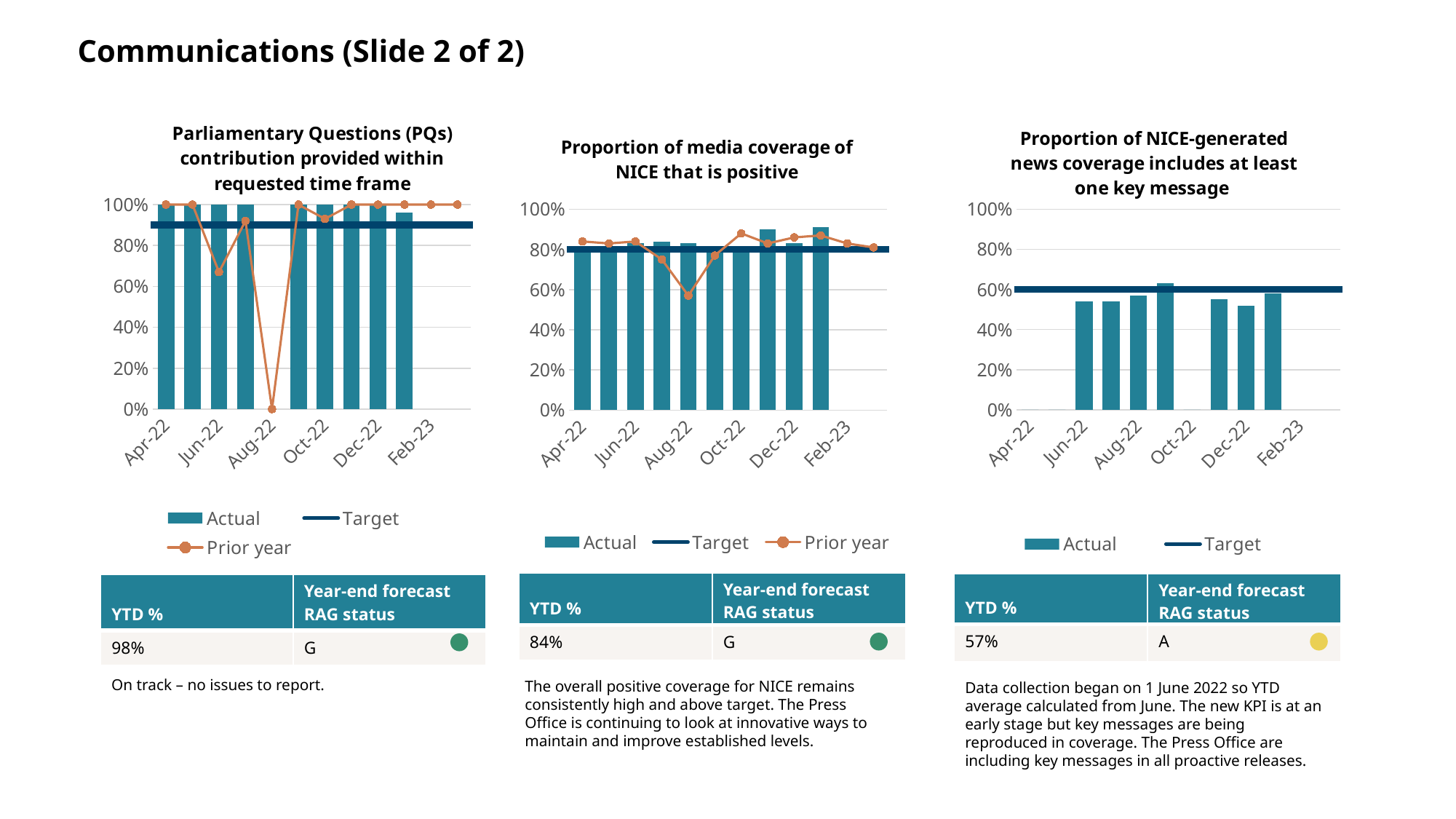
In the 'Proportion of NICE-generated news coverage includes at least one key message' chart, which month has the highest Actual bar? Sep-22 In the 'Proportion of NICE-generated news coverage includes at least one key message' chart, how many Actual bars are plotted? 7 What kind of chart is the 'Proportion of NICE-generated news coverage includes at least one key message' chart? bar chart In the 'Parliamentary Questions (PQs) contribution provided within requested time frame' chart, how many Actual bars are plotted? 9 What is the title of the middle chart on the slide? Proportion of media coverage of NICE that is positive In the 'Parliamentary Questions (PQs) contribution provided within requested time frame' chart, which month has the lowest Prior year value? Aug-22 In the 'Proportion of media coverage of NICE that is positive' chart, is the Actual value for Nov-22 greater or less than 80%? greater In the 'Proportion of NICE-generated news coverage includes at least one key message' chart, is the Actual value for Jun-22 greater or less than 60%? less In the 'Proportion of NICE-generated news coverage includes at least one key message' chart, how many series does the legend list? 2 In the 'Parliamentary Questions (PQs) contribution provided within requested time frame' chart, what is the Prior year value for Aug-22? 0% In the 'Parliamentary Questions (PQs) contribution provided within requested time frame' chart, which is larger: the Prior year value for Jun-22 or for Jul-22? Jul-22 In the 'Parliamentary Questions (PQs) contribution provided within requested time frame' chart, how many series does the legend list? 3